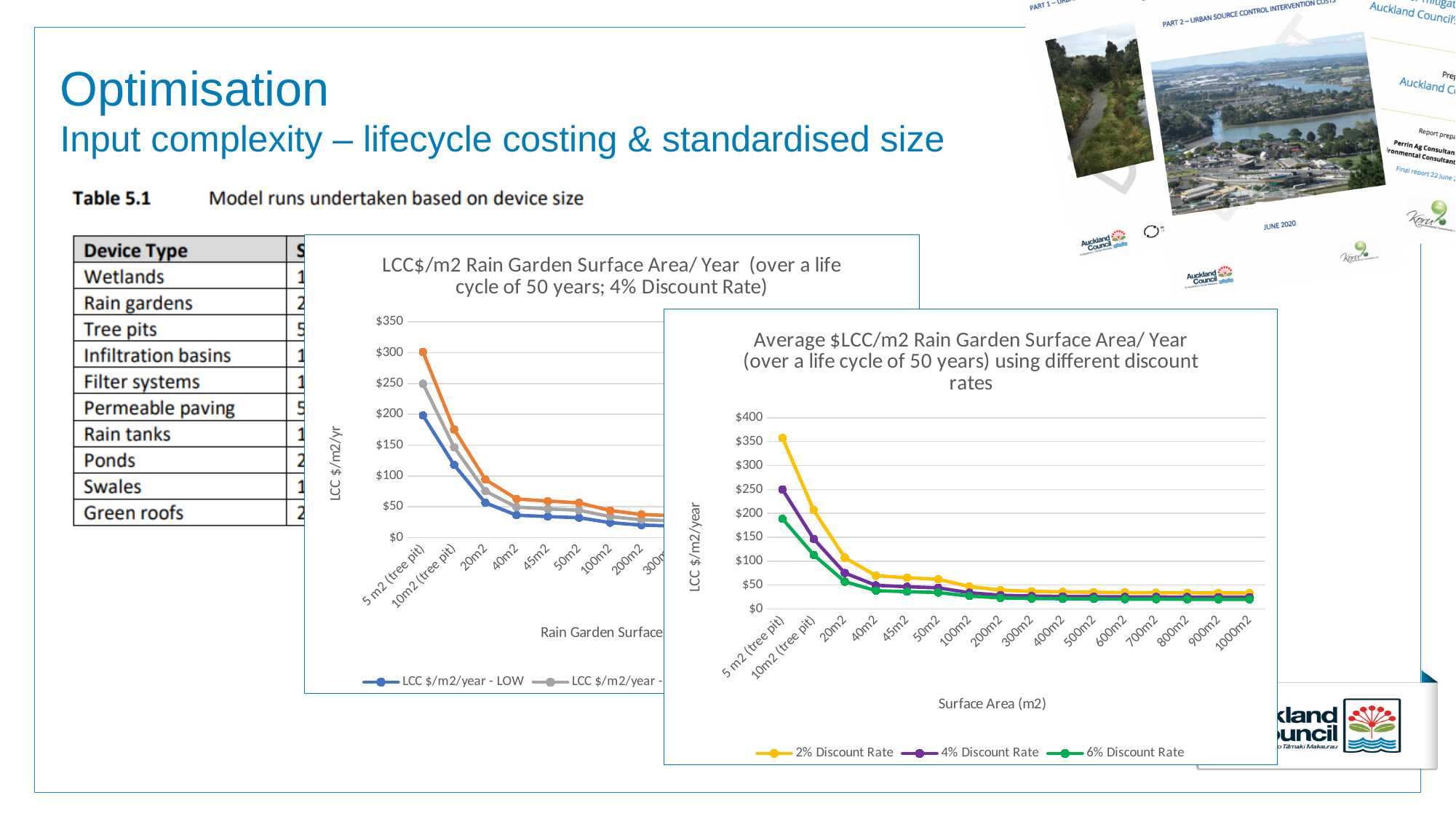
On the chart titled 'Average $LCC/m2 Rain Garden Surface Area/ Year (over a life cycle of 50 years) using different discount rates', what colour is the line for the 4% Discount Rate? Purple On the chart titled 'Average $LCC/m2 Rain Garden Surface Area/ Year (over a life cycle of 50 years) using different discount rates', is the value for the 2% Discount Rate at 5 m2 (tree pit) greater or less than $300? greater On the chart titled 'Average $LCC/m2 Rain Garden Surface Area/ Year (over a life cycle of 50 years) using different discount rates', what kind of chart is shown? Line chart On the chart titled 'Average $LCC/m2 Rain Garden Surface Area/ Year (over a life cycle of 50 years) using different discount rates', is the value for the 6% Discount Rate at 5 m2 (tree pit) greater or less than $150? greater On the chart titled 'LCC$/m2 Rain Garden Surface Area/ Year (over a life cycle of 50 years; 4% Discount Rate)', is the value for 'LCC $/m2/year - LOW' at 5 m2 (tree pit) greater or less than $150? greater On the chart titled 'Average $LCC/m2 Rain Garden Surface Area/ Year (over a life cycle of 50 years) using different discount rates', at 5 m2 (tree pit), which series has the higher value: 2% Discount Rate or 6% Discount Rate? 2% Discount Rate On the chart titled 'LCC$/m2 Rain Garden Surface Area/ Year (over a life cycle of 50 years; 4% Discount Rate)', what kind of chart is shown? Line chart On the chart titled 'Average $LCC/m2 Rain Garden Surface Area/ Year (over a life cycle of 50 years) using different discount rates', do the values rise or fall as surface area increases along the x axis? Fall On the chart titled 'Average $LCC/m2 Rain Garden Surface Area/ Year (over a life cycle of 50 years) using different discount rates', what is the x-axis title? Surface Area (m2) On the chart titled 'Average $LCC/m2 Rain Garden Surface Area/ Year (over a life cycle of 50 years) using different discount rates', how many series does the legend list? 3 On the chart titled 'Average $LCC/m2 Rain Garden Surface Area/ Year (over a life cycle of 50 years) using different discount rates', how many surface area categories are shown on the x axis? 16 On the chart titled 'Average $LCC/m2 Rain Garden Surface Area/ Year (over a life cycle of 50 years) using different discount rates', which series has the highest value at 5 m2 (tree pit)? 2% Discount Rate